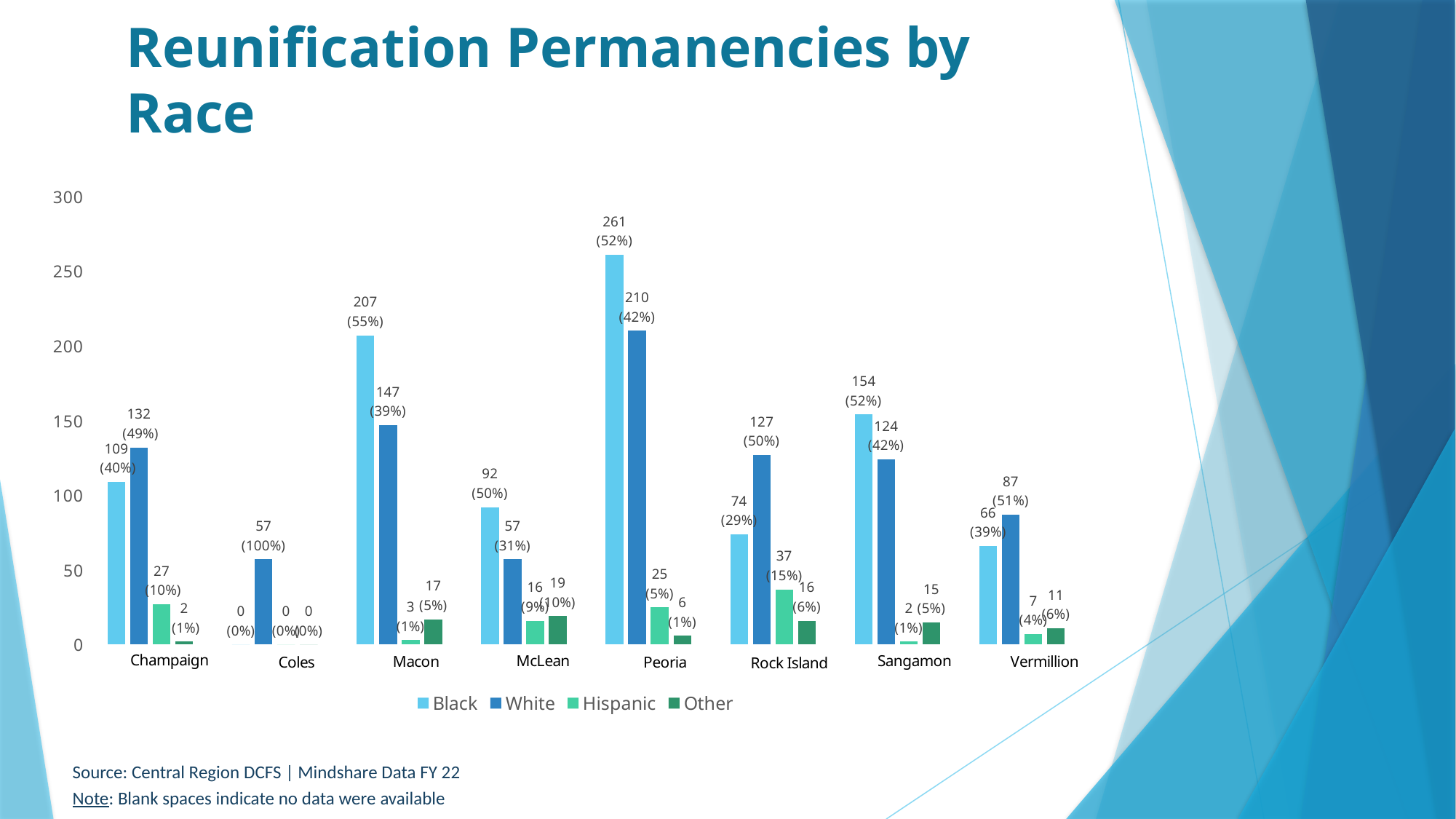
How many series does the legend list? 4 What value is shown for the Other series in McLean? 19 How many counties are shown on the x axis? 8 Which county has the highest value for the Black series? Peoria Is the value for the Black series in Sangamon greater or less than 150? greater What value is shown for the Black series in Peoria? 261 What value is shown for the White series in Rock Island? 127 What is the difference between the Black and White values in Macon? 60 Which is larger in Champaign, the Black value or the White value? White Which county has the lowest value for the White series? Coles and McLean (57 each) What percentage is shown in the label for the Hispanic bar in Rock Island? 15% What type of chart is shown on the slide? Bar chart